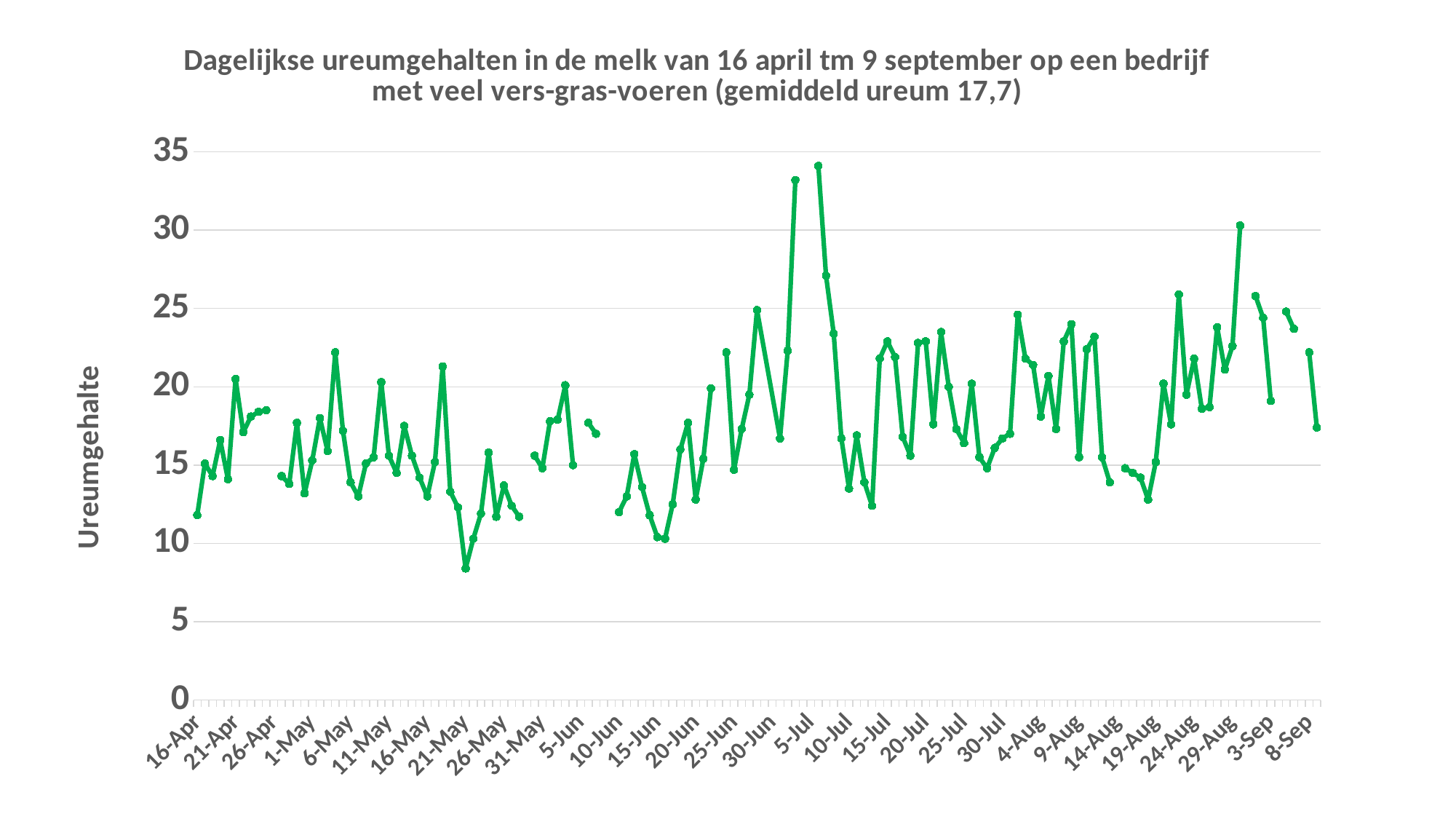
Is the value for 16-Apr greater or less than 15? less Around which labelled date does the line reach its highest value? 5-Jul Is the value for 15-Jun greater or less than 15? less Is the value for 24-Aug greater or less than 20? greater Do the values rise or fall between 30-Jun and 5-Jul? rise What kind of chart is shown on the slide? line chart What is the label of the vertical axis? Ureumgehalte What is the title of the chart? Dagelijkse ureumgehalten in de melk van 16 april tm 9 september op een bedrijf met veel vers-gras-voeren (gemiddeld ureum 17,7) Do the values rise or fall between 5-Jul and 10-Jul? fall